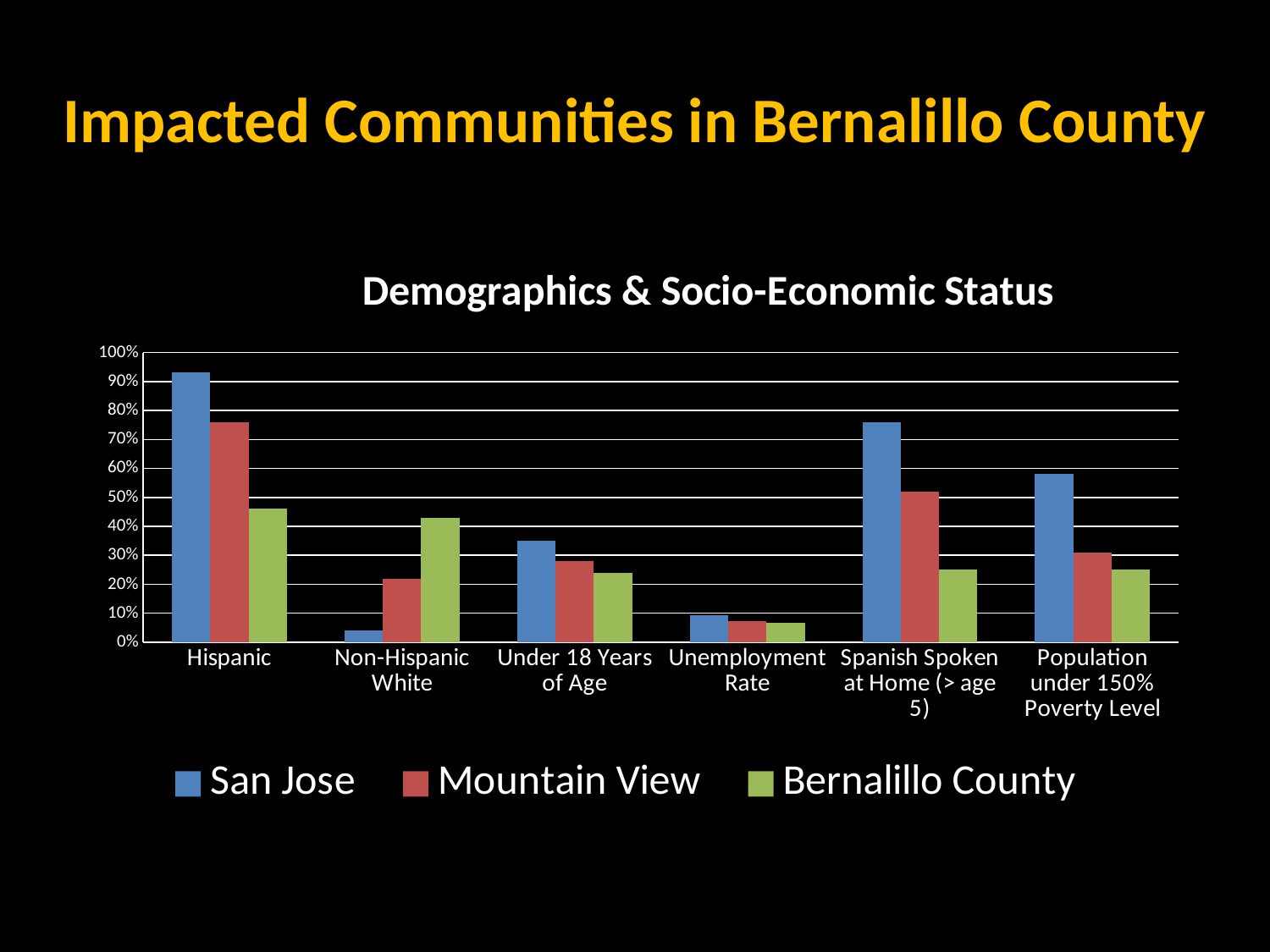
How many series does the legend list? 3 Which series has the highest bar in the Non-Hispanic White category? Bernalillo County Is the Mountain View value for Spanish Spoken at Home (> age 5) greater or less than 40%? greater What is the title of the chart? Demographics & Socio-Economic Status For which category is the San Jose bar the highest? Hispanic Is the San Jose value for Hispanic greater or less than 90%? greater What kind of chart is shown on the slide? Bar chart Is the Bernalillo County value for Spanish Spoken at Home (> age 5) greater or less than 30%? less In the Non-Hispanic White category, which is larger: San Jose or Bernalillo County? Bernalillo County For which category is the San Jose bar the lowest? Non-Hispanic White How many categories are shown along the x axis? 6 In the Hispanic category, which is larger: San Jose or Bernalillo County? San Jose